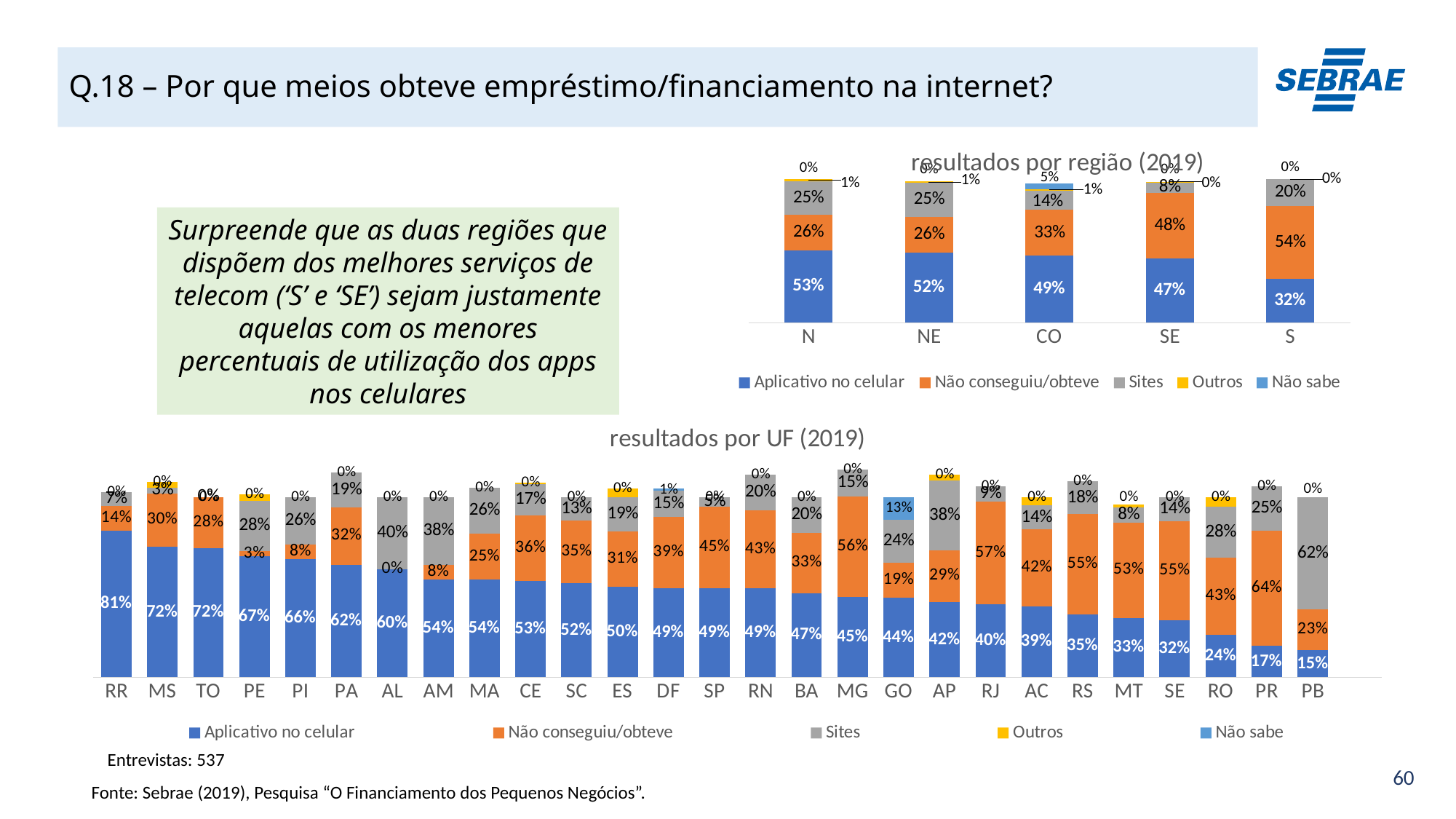
In the 'resultados por UF (2019)' chart, which is larger: the 'Não conseguiu/obteve' value for PR or for MG? PR In the 'resultados por região (2019)' chart, what is the value of 'Aplicativo no celular' for region N? 53% In the 'resultados por UF (2019)' chart, which UF has the lowest 'Aplicativo no celular' value? PB In the 'resultados por região (2019)' chart, what is the difference between the 'Sites' values for N and SE? 17% In the 'resultados por UF (2019)' chart, which UF has the highest 'Sites' value? PB In the 'resultados por região (2019)' chart, how many regions are shown on the x axis? 5 In the 'resultados por UF (2019)' chart, how many UFs are shown on the x axis? 27 What type of chart is 'resultados por região (2019)'? Stacked bar chart How many series does the legend of the 'resultados por UF (2019)' chart list? 5 In the 'resultados por região (2019)' chart, what is the value of 'Não conseguiu/obteve' for region S? 54% In the 'resultados por UF (2019)' chart, what is the 'Aplicativo no celular' value for RR? 81% In the 'resultados por região (2019)' chart, which region has the lowest 'Aplicativo no celular' value? S